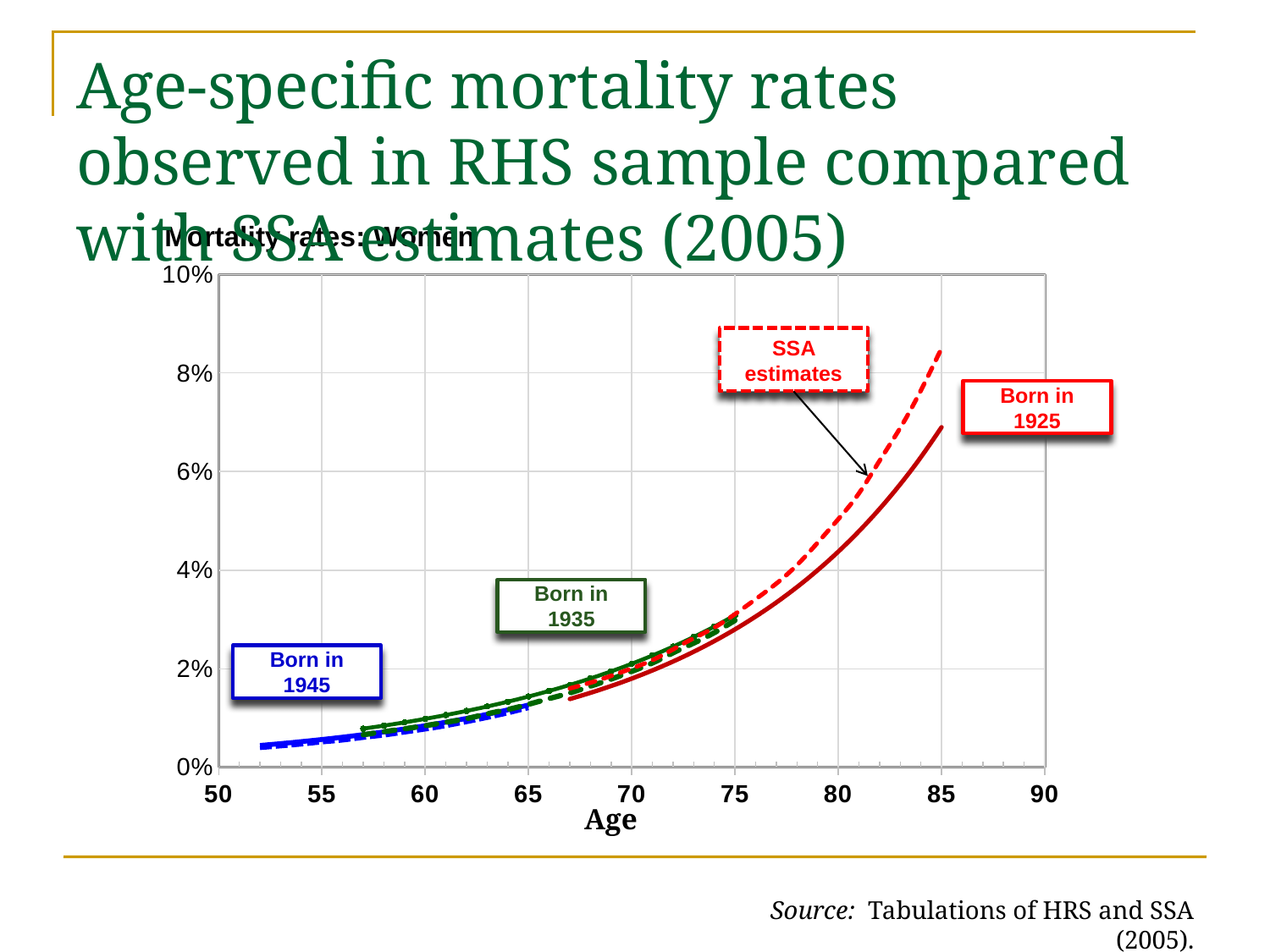
What is the title of the chart? Mortality rates: Women Which birth cohort reaches the highest mortality rate on the chart? Born in 1925 What is the highest value shown on the y axis? 10% Is the observed mortality rate for the Born in 1925 cohort at age 85 greater or less than 6%? greater Is the SSA estimate for the Born in 1925 cohort at age 85 greater or less than 8%? greater What is the label of the x axis? Age What kind of chart is shown on the slide? line chart How many birth cohorts are labelled on the chart? 3 Is the mortality rate for the Born in 1935 cohort at age 65 greater or less than 2%? less At age 85, which is higher for the Born in 1925 cohort: the SSA estimate or the observed mortality rate? SSA estimate Do the mortality rates rise or fall as age increases along the x axis? rise